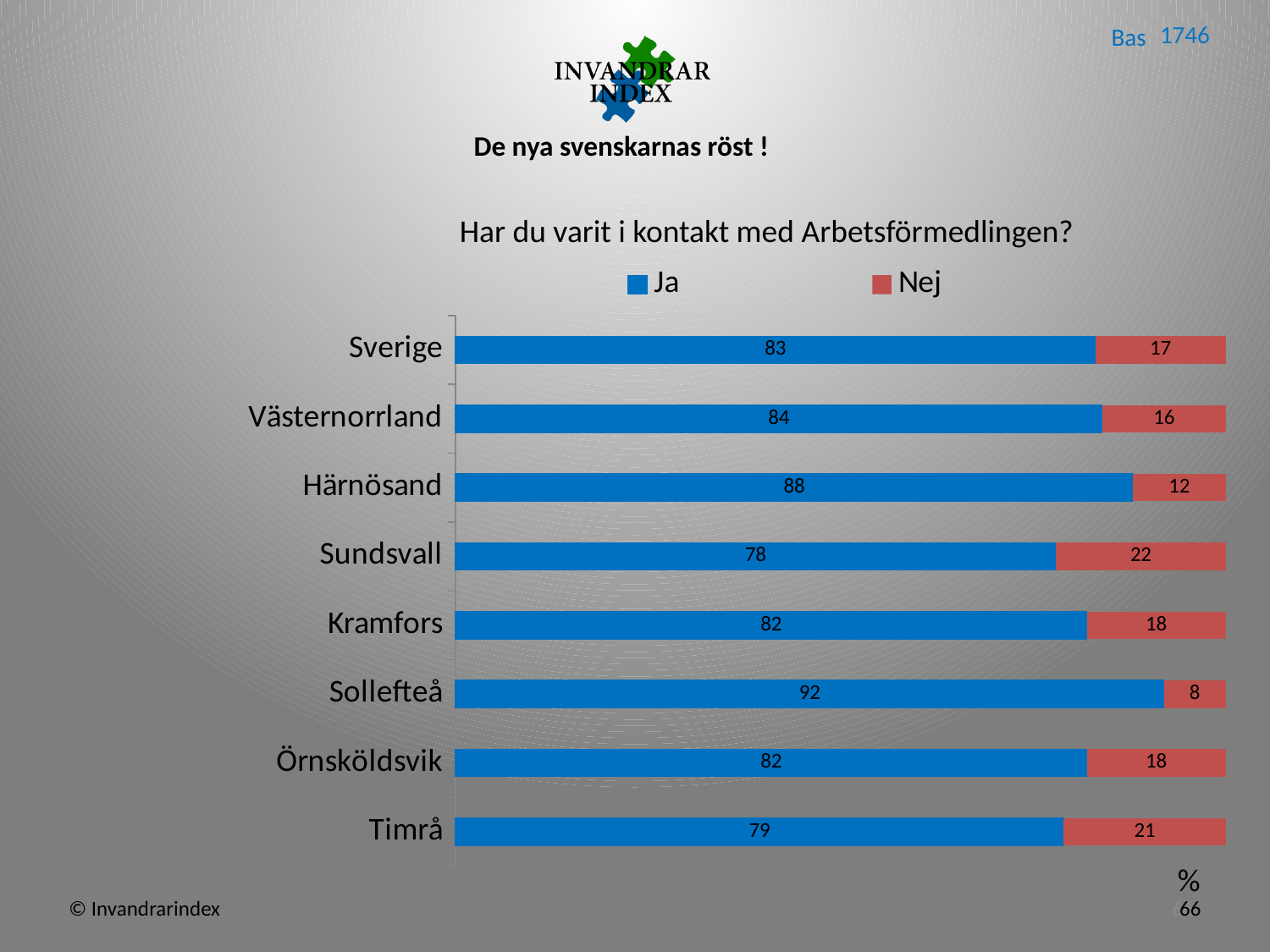
What kind of chart is shown on the slide? Stacked bar chart What is the "Ja" value for Härnösand? 88 What is the "Nej" value for Sundsvall? 22 What is the difference between the "Ja" values for Sollefteå and Sundsvall? 14 Which category has the lowest "Ja" value? Sundsvall How many series does the legend list? 2 What is the total of the stacked bar for Kramfors? 100 Which is larger, the "Nej" value for Timrå or the "Nej" value for Västernorrland? Timrå How many categories are shown on the chart? 8 Which category has the highest "Ja" value? Sollefteå What is the "Ja" value for Timrå? 79 Which category has the lowest "Nej" value? Sollefteå